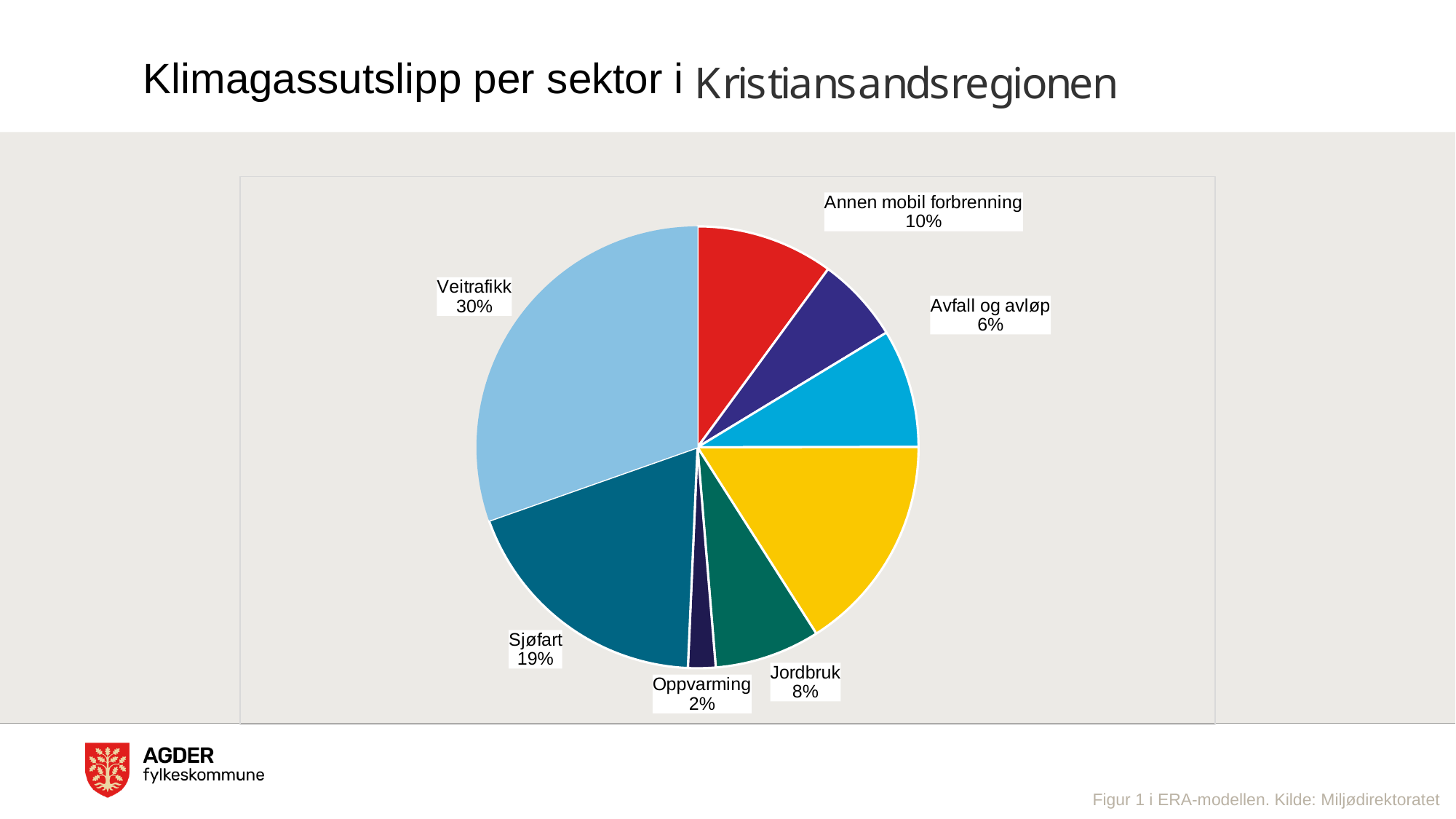
What percentage is shown for Sjøfart? 19% What share of emissions does Veitrafikk account for? 30% What percentage is shown for Annen mobil forbrenning? 10% What percentage is shown for Avfall og avløp? 6% What percentage is shown for Oppvarming? 2% What kind of chart is shown on the slide? pie chart How many percentage points larger is Veitrafikk's share than Sjøfart's? 11 Which sector has the smallest share of the pie? Oppvarming How many slices does the pie chart have? 8 Which has a larger share, Jordbruk or Avfall og avløp? Jordbruk Which sector has the largest share of the pie? Veitrafikk What percentage is shown for Jordbruk? 8%